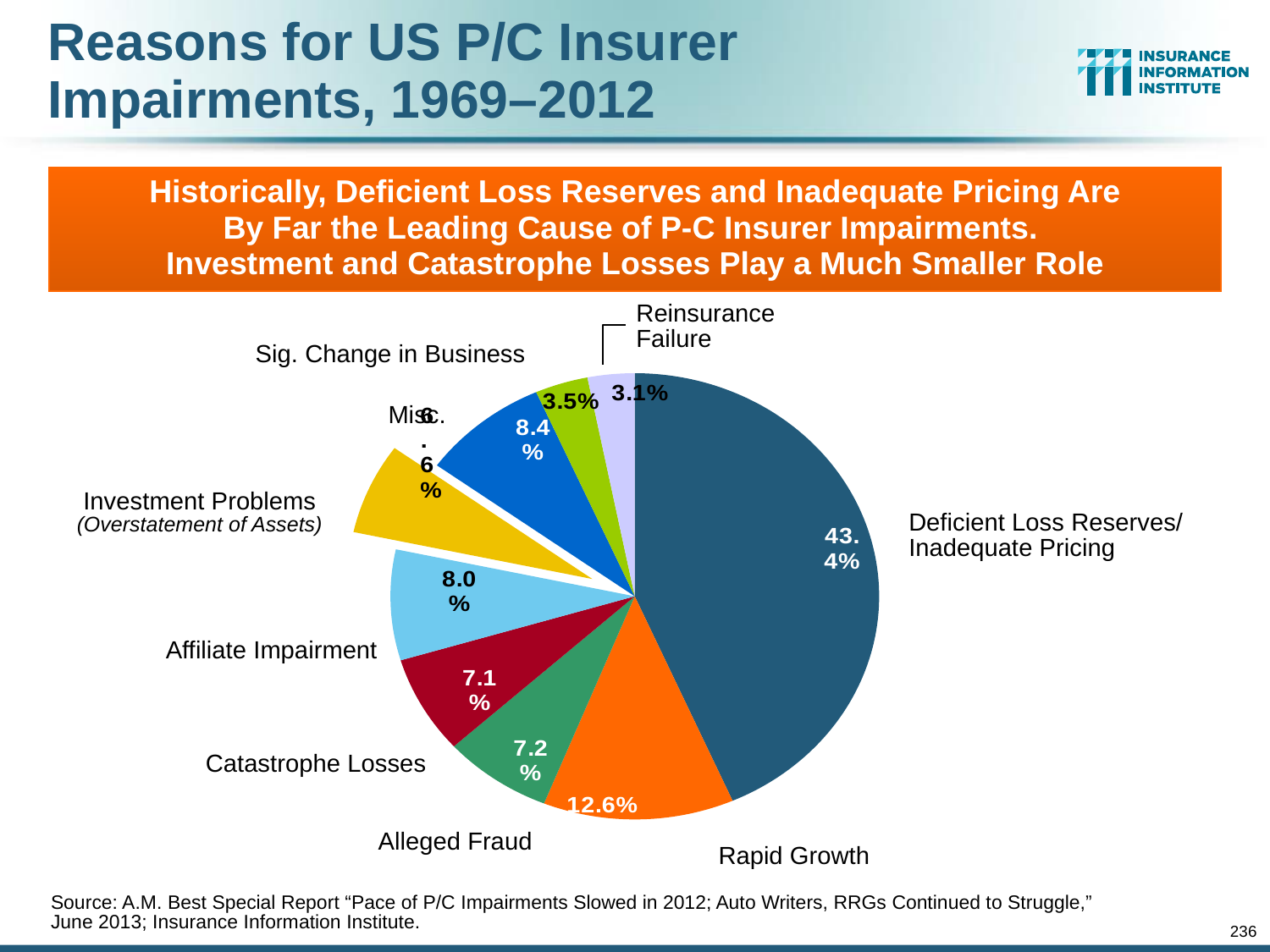
What share of US P/C insurer impairments is attributed to Deficient Loss Reserves/Inadequate Pricing? 43.4% How many slices does the pie chart have? 9 What percentage of impairments is attributed to Affiliate Impairment? 8.0% What kind of chart is shown on the slide? Pie chart What percentage of impairments is attributed to Rapid Growth? 12.6% Which is larger, the share for Rapid Growth or the share for Affiliate Impairment? Rapid Growth Which reason accounts for the smallest share of impairments? Reinsurance Failure What percentage of impairments is attributed to Alleged Fraud? 7.2% Which reason accounts for the largest share of impairments? Deficient Loss Reserves/Inadequate Pricing What percentage of impairments is attributed to Reinsurance Failure? 3.1% How many percentage points larger is the Deficient Loss Reserves/Inadequate Pricing share than the Rapid Growth share? 30.8 percentage points What percentage of impairments is attributed to Catastrophe Losses? 7.1%